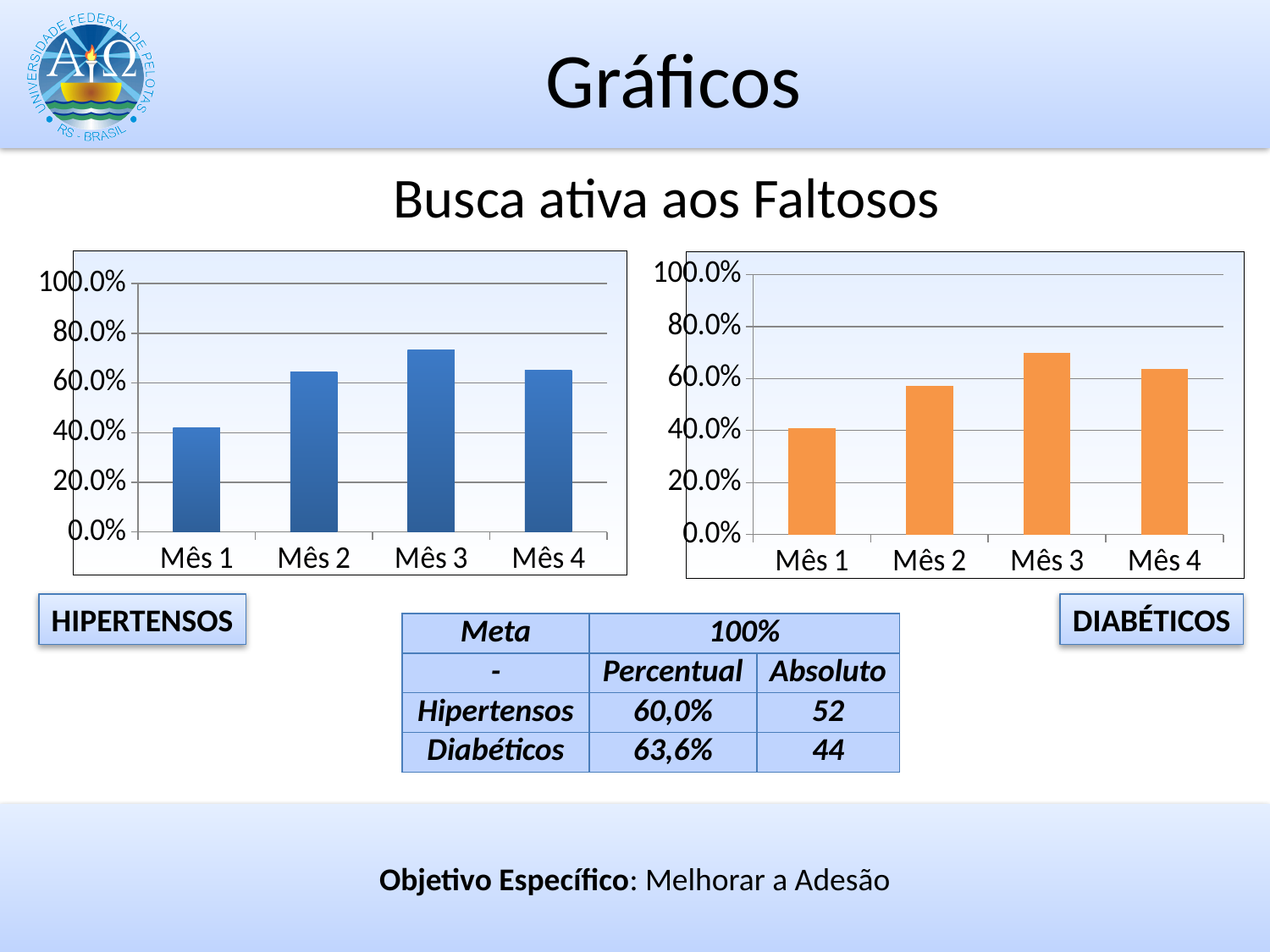
How many months are shown on the x axis of the HIPERTENSOS chart (left)? 4 In the DIABÉTICOS chart (right), which is larger, the value for Mês 2 or Mês 4? Mês 4 In the HIPERTENSOS chart (left), which month has the lowest value? Mês 1 In the DIABÉTICOS chart (right), which month has the lowest value? Mês 1 In the DIABÉTICOS chart (right), is the value for Mês 3 greater or less than 60%? greater In the DIABÉTICOS chart (right), is the value for Mês 1 greater or less than 60%? less In the HIPERTENSOS chart (left), which month has the highest value? Mês 3 In the HIPERTENSOS chart (left), is the value for Mês 1 greater or less than 60%? less What colour are the bars in the DIABÉTICOS chart (right)? Orange What kind of chart is the DIABÉTICOS chart (right)? Bar chart In the DIABÉTICOS chart (right), which month has the highest value? Mês 3